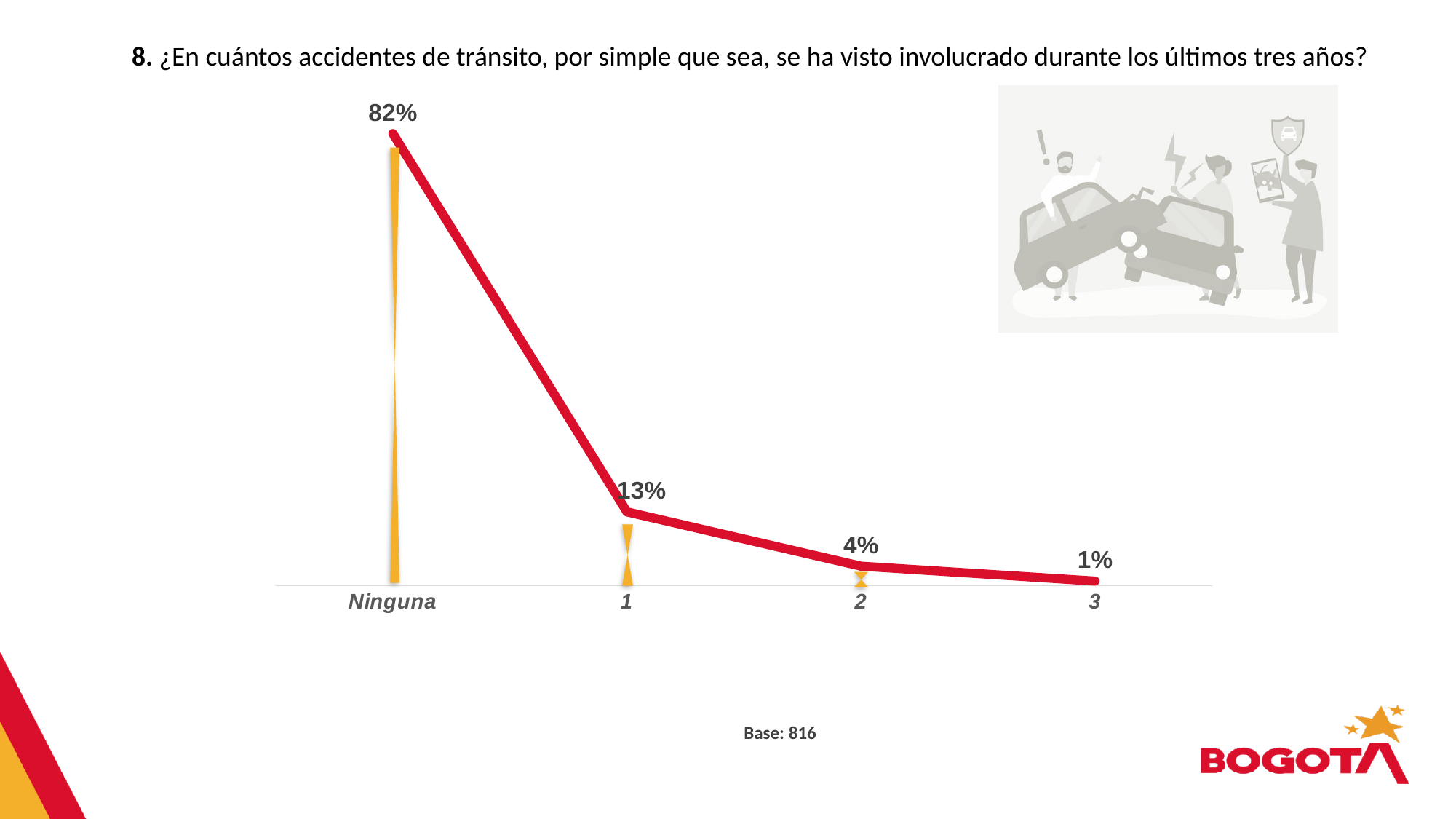
How many categories are shown on the x axis? 4 Which category has the highest value? Ninguna What is the value for category 1? 13% Do the values rise or fall from left to right along the x axis? fall What is the difference between the values for 1 and 2? 9% What is the value for category 2? 4% What is the value for Ninguna? 82% What is the base (sample size) stated on the slide? 816 Which is larger, the value for 2 or the value for 3? 2 What is the value for category 3? 1% Which category has the lowest value? 3 What is the difference between the values for Ninguna and 1? 69%